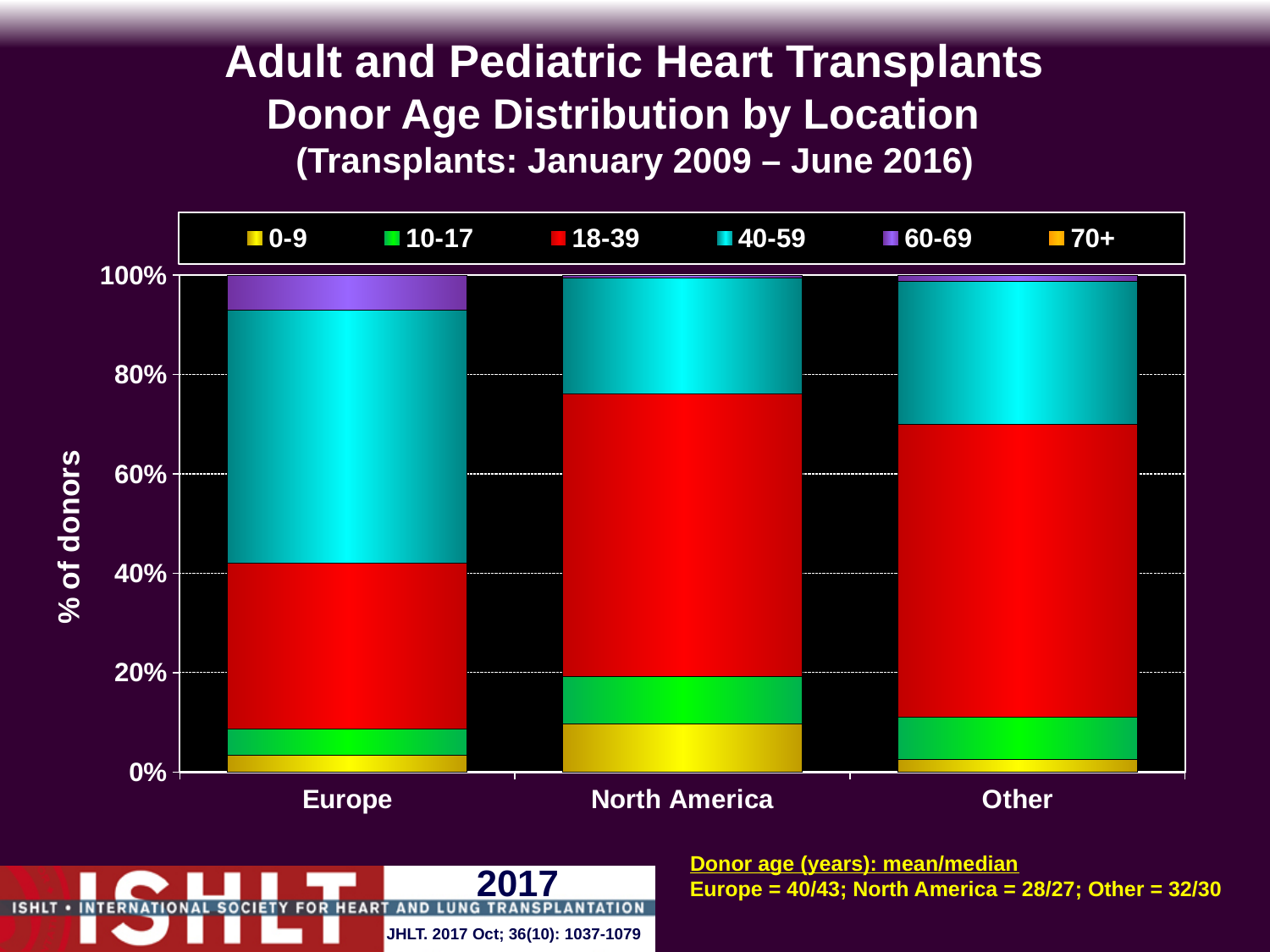
Which location has the largest 40-59 donor age segment? Europe Is the 18-39 segment for Europe greater or less than 40%? less Which location has the largest 0-9 donor age segment? North America Is the 40-59 segment for Europe greater or less than 40%? greater How many donor age groups does the legend list? 6 Which location has the largest 60-69 donor age segment? Europe Which is larger: the 40-59 segment for Other or the 40-59 segment for Europe? Europe Which is larger: the 18-39 segment for Europe or the 18-39 segment for North America? North America Is the 0-9 segment for North America greater or less than 20%? less What is the label on the y axis? % of donors What kind of chart is shown on the slide? Stacked bar chart How many locations are shown along the x axis? 3